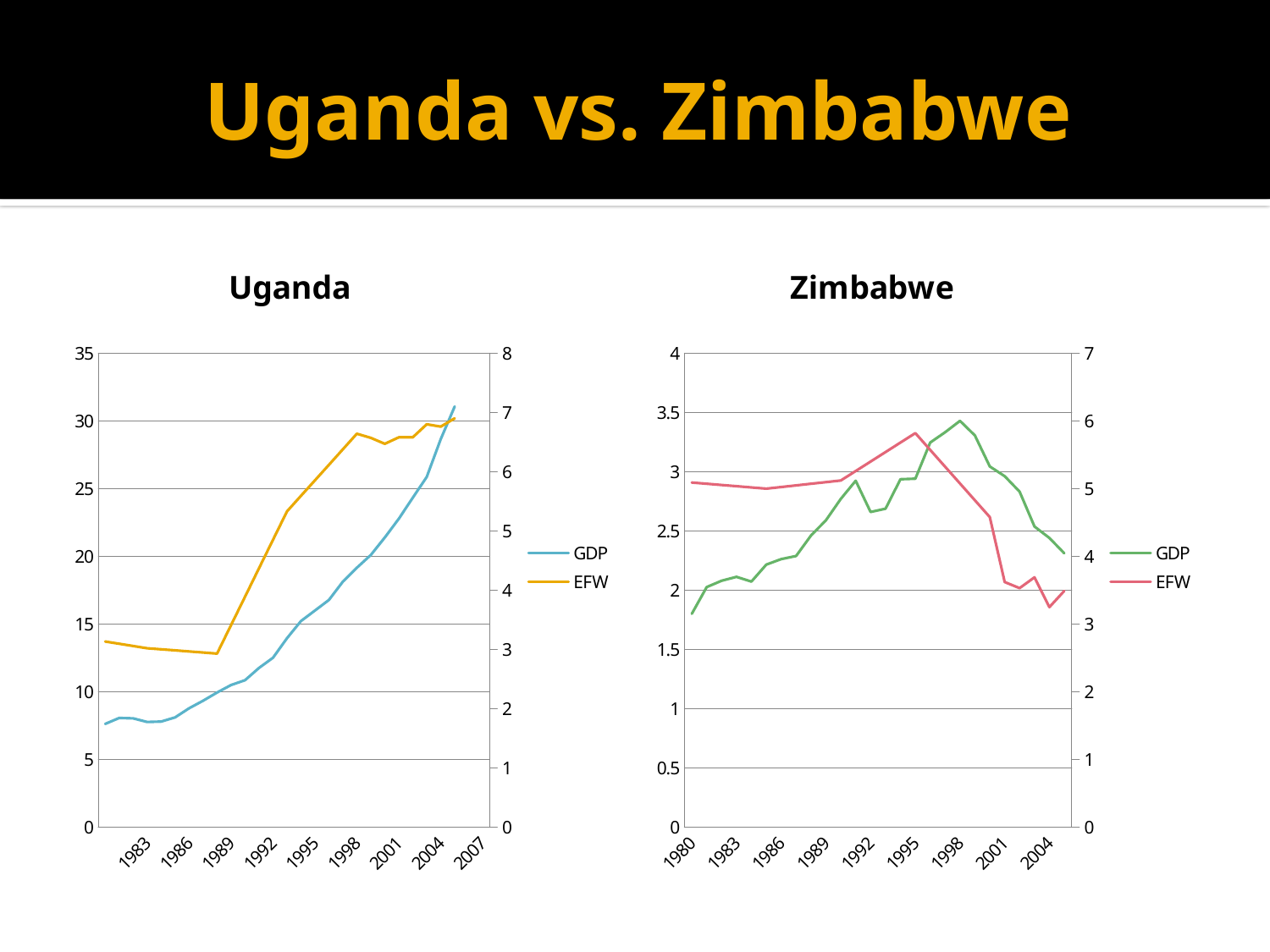
In the Uganda chart, does the EFW line rise or fall from 1989 to 1998? rise In the Zimbabwe chart, does the EFW line rise or fall from 1995 to 2004? fall In the Zimbabwe chart, is the GDP value for 1980 greater or less than 2? less What kind of chart is the Uganda chart? line chart In the Uganda chart, is the GDP value for 1983 greater or less than 10? less In the Zimbabwe chart, is the EFW value for 1995 greater or less than 5? greater How many series does the legend of the Zimbabwe chart list? 2 What are the two series named in the legend of the Uganda chart? GDP and EFW In the Uganda chart, does the GDP line rise or fall overall from 1983 to 2007? rise